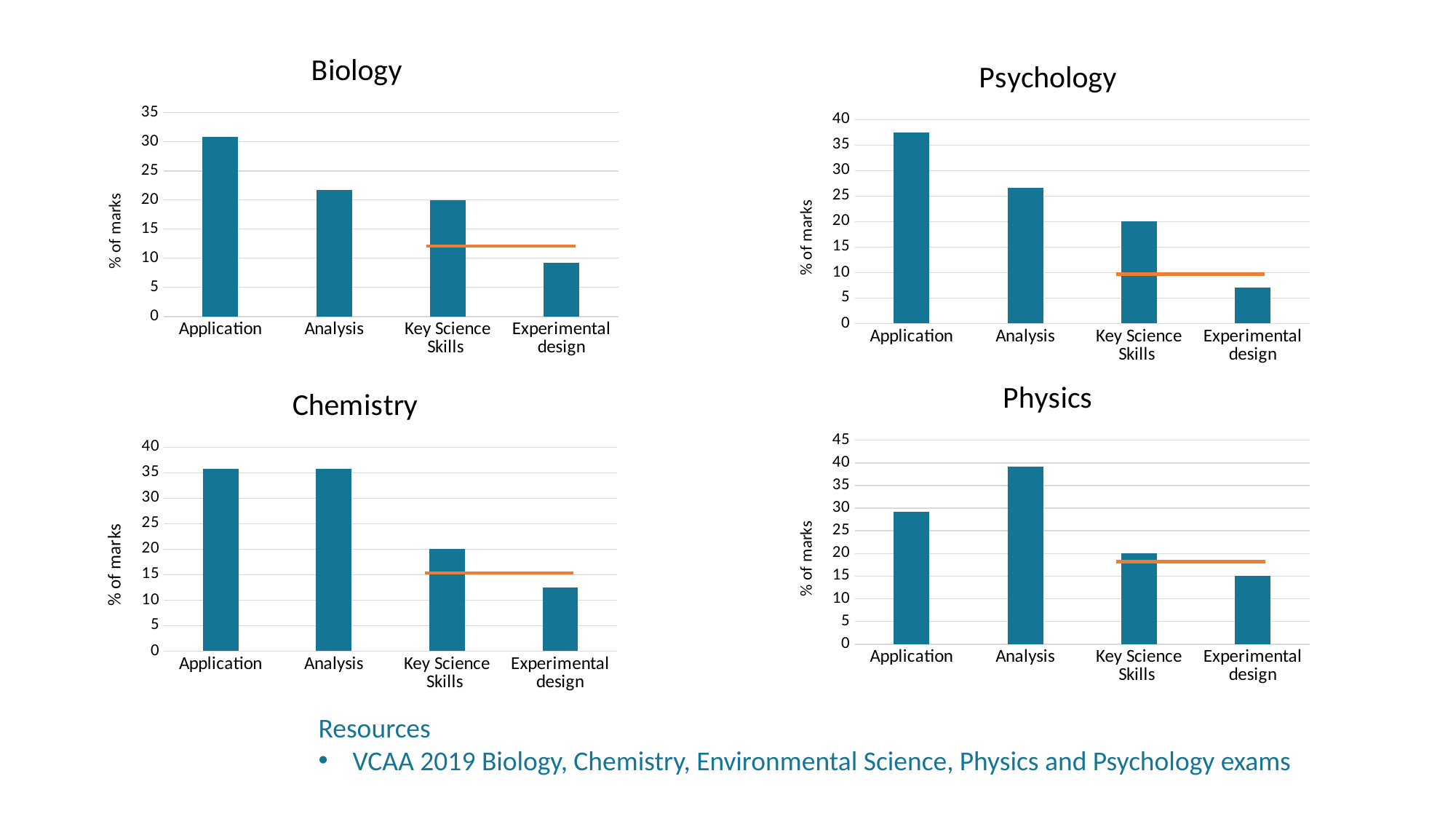
In the Chemistry chart, which category has the lowest percentage of marks? Experimental design In the Psychology chart, which category has the highest percentage of marks? Application In the Biology chart, is the value for Application greater or less than 30? greater How many categories are shown on the x axis of the Physics chart? 4 In the Psychology chart, is the value for Experimental design greater or less than 10? less In the Biology chart, which category has the highest percentage of marks? Application In the Physics chart, which is larger, Application or Key Science Skills? Application In the Chemistry chart, is the value for Application greater or less than 35? greater What type of chart is the Chemistry chart? Bar chart In the Psychology chart, which is larger, Analysis or Key Science Skills? Analysis In the Biology chart, which category has the lowest percentage of marks? Experimental design In the Physics chart, which category has the highest percentage of marks? Analysis